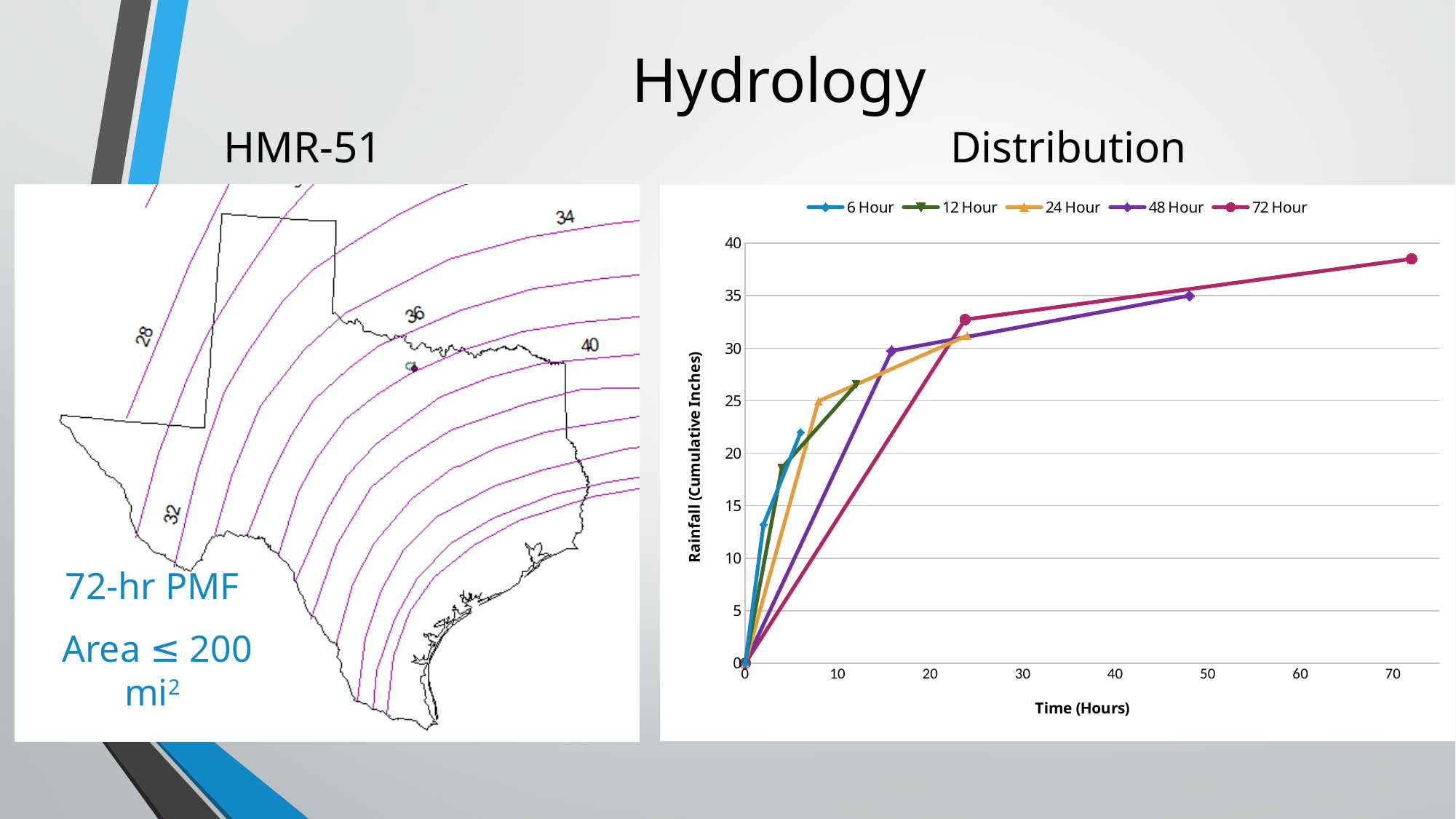
In the Distribution chart, which series reaches the lowest final cumulative rainfall? 6 Hour In the Distribution chart, which series reaches the highest cumulative rainfall? 72 Hour In the Distribution chart, is the final value of the 72 Hour series greater or less than 35? greater In the Distribution chart, which series reaches a higher final cumulative rainfall, 48 Hour or 24 Hour? 48 Hour How many series does the legend of the Distribution chart list? 5 In the Distribution chart, is the final value of the 24 Hour series greater or less than 30? greater What is the y-axis title of the Distribution chart? Rainfall (Cumulative Inches) In the Distribution chart, is the final value of the 12 Hour series greater or less than 30? less What are the series names in the legend of the Distribution chart? 6 Hour, 12 Hour, 24 Hour, 48 Hour, 72 Hour In the Distribution chart, do the cumulative rainfall values rise or fall as time increases? rise What kind of chart is the Distribution chart? line chart